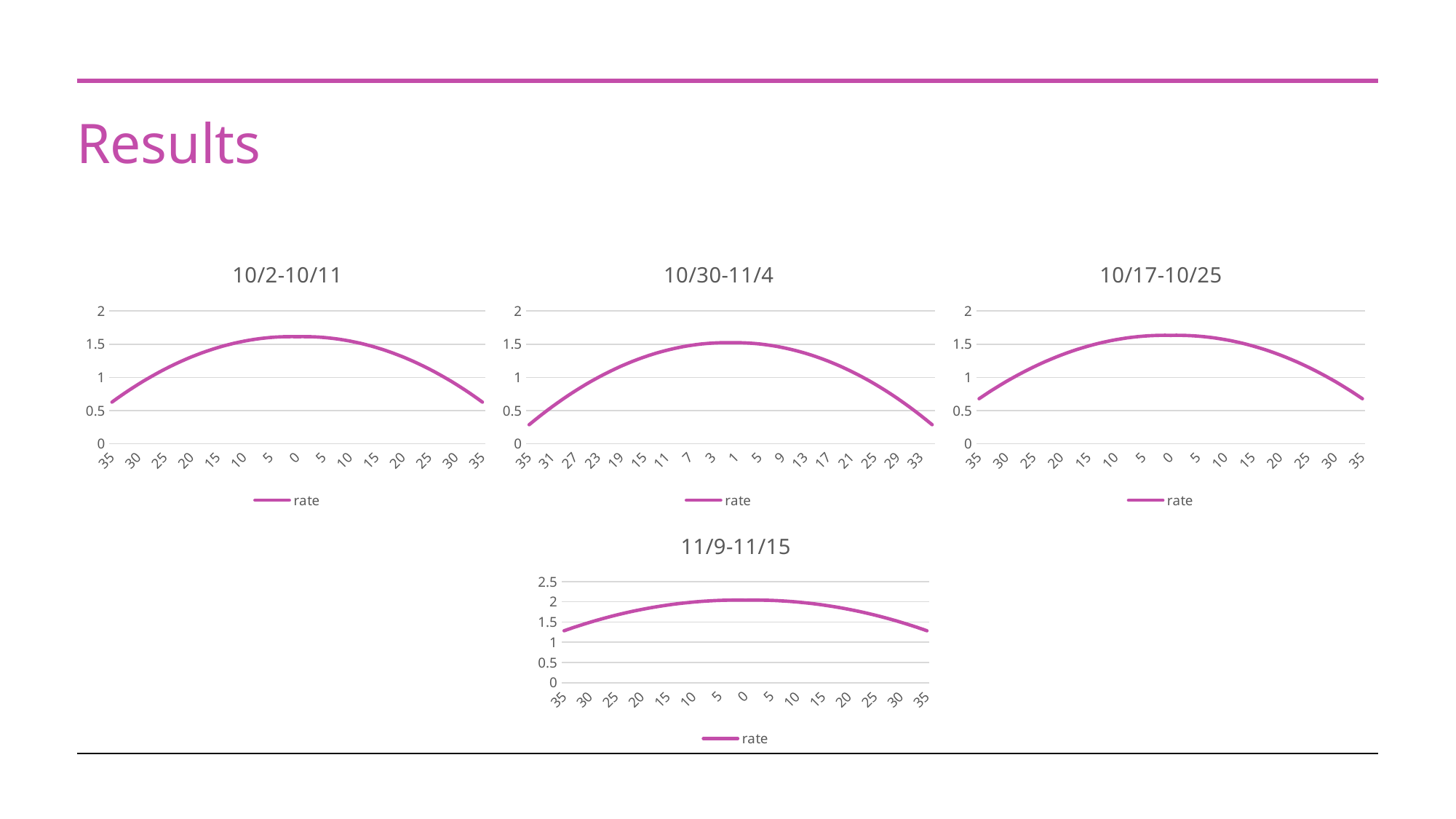
In the 10/17-10/25 chart, is the value at x = 0 greater or less than 1.5? greater What kind of chart is the 10/2-10/11 chart? line chart In the 10/2-10/11 chart, at which x label does the line reach its highest value? 0 In the 10/30-11/4 chart, which is larger: the value at the leftmost x label 35 or the value at x = 1? the value at x = 1 What is the title of the chart at the bottom of the slide? 11/9-11/15 In the 11/9-11/15 chart, is the value at the rightmost x label 35 greater or less than 1.5? less How many series does the legend of the 11/9-11/15 chart list? 1 In the 10/2-10/11 chart, is the value at the leftmost x label 35 greater or less than 1? less